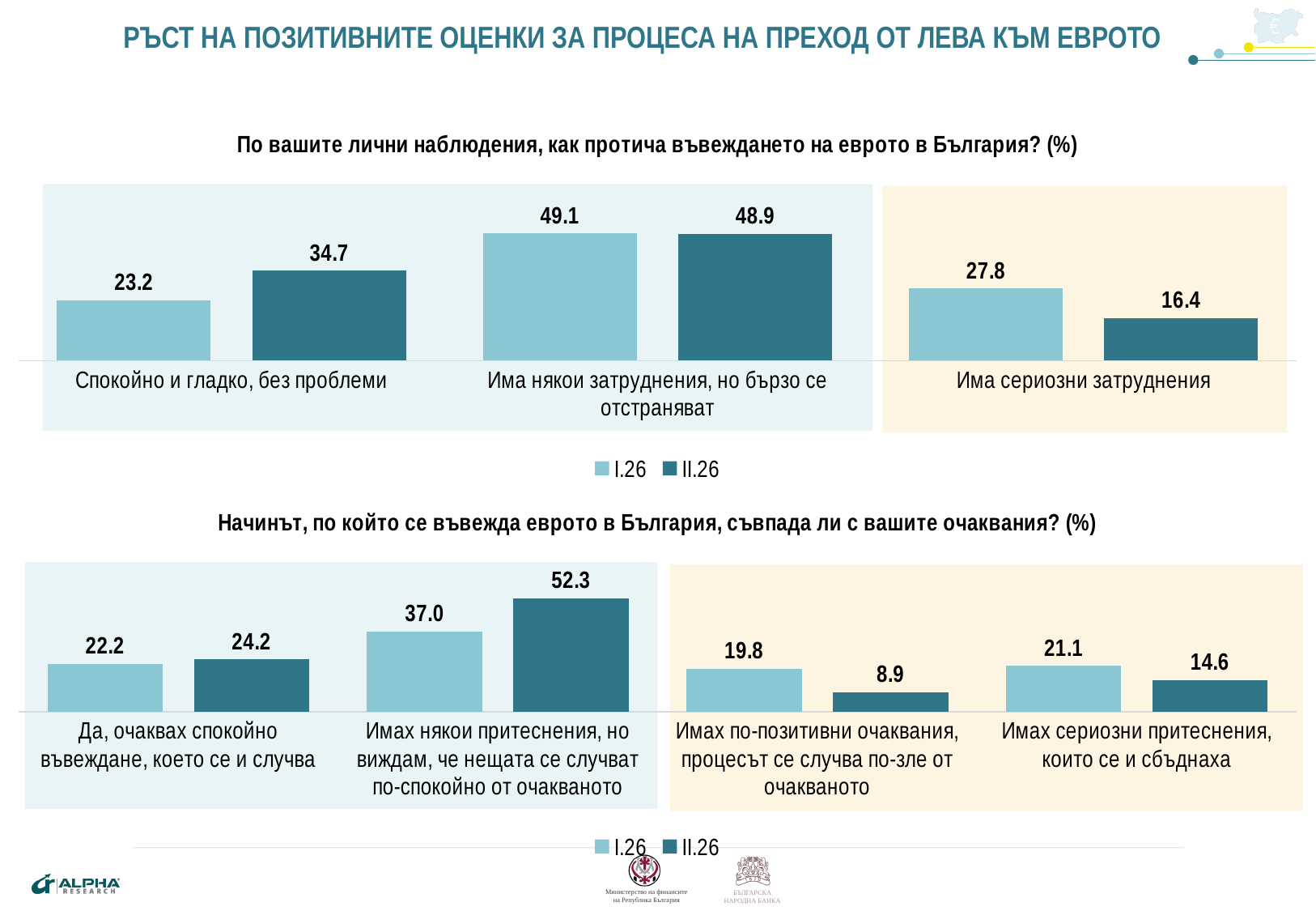
In the bottom chart, what is the II.26 value for "Имах някои притеснения, но виждам, че нещата се случват по-спокойно от очакваното"? 52.3 In the top chart, which category has the highest I.26 value? Има някои затруднения, но бързо се отстраняват In the top chart, what is the I.26 value for "Има сериозни затруднения"? 27.8 In the bottom chart, what is the difference between the II.26 and I.26 values for "Да, очаквах спокойно въвеждане, което се и случва"? 2.0 In the bottom chart, which category has the lowest II.26 value? Имах по-позитивни очаквания, процесът се случва по-зле от очакваното In the top chart, how many series does the legend list? 2 What type of chart is the bottom chart? Bar chart In the top chart, what is the difference between the I.26 and II.26 values for "Има сериозни затруднения"? 11.4 In the top chart, how many categories are shown? 3 In the top chart, what is the II.26 value for "Спокойно и гладко, без проблеми"? 34.7 In the bottom chart, what is the I.26 value for "Имах по-позитивни очаквания, процесът се случва по-зле от очакваното"? 19.8 In the bottom chart, is the I.26 value or the II.26 value larger for "Имах сериозни притеснения, които се и сбъднаха"? I.26